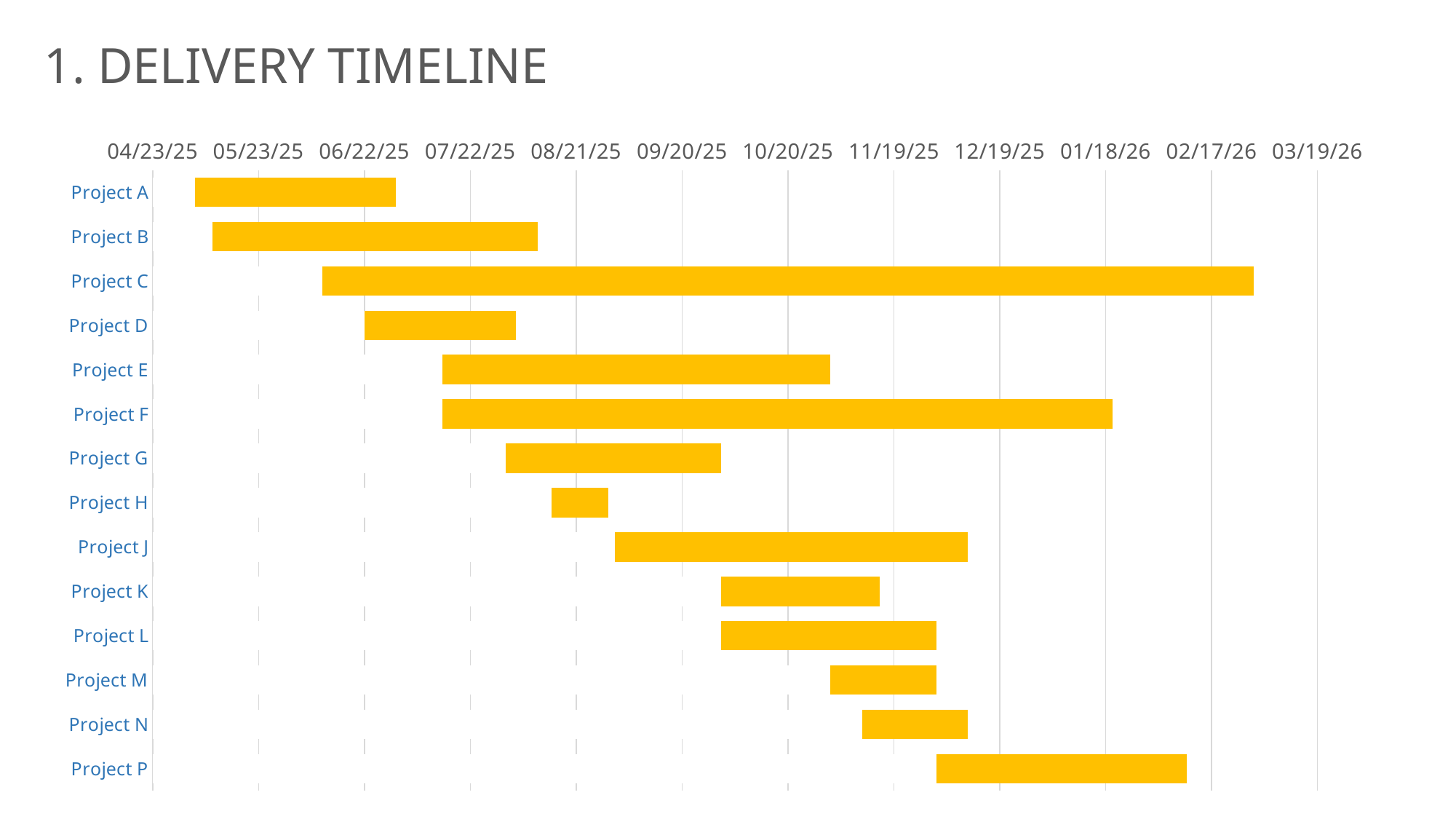
Which bar is longer, Project F or Project E? Project F Does the bar for Project H start before or after 07/22/25? after Does the bar for Project C end before or after 02/17/26? after Which project has the longest bar on the timeline? Project C Which project's bar starts earliest on the timeline? Project A Which project has the shortest bar on the timeline? Project H Does the bar for Project E end before or after 11/19/25? before How many projects are listed on the chart? 14 What kind of chart is shown on the slide? bar chart Which bar is longer, Project B or Project A? Project B Which project's bar starts latest on the timeline? Project P